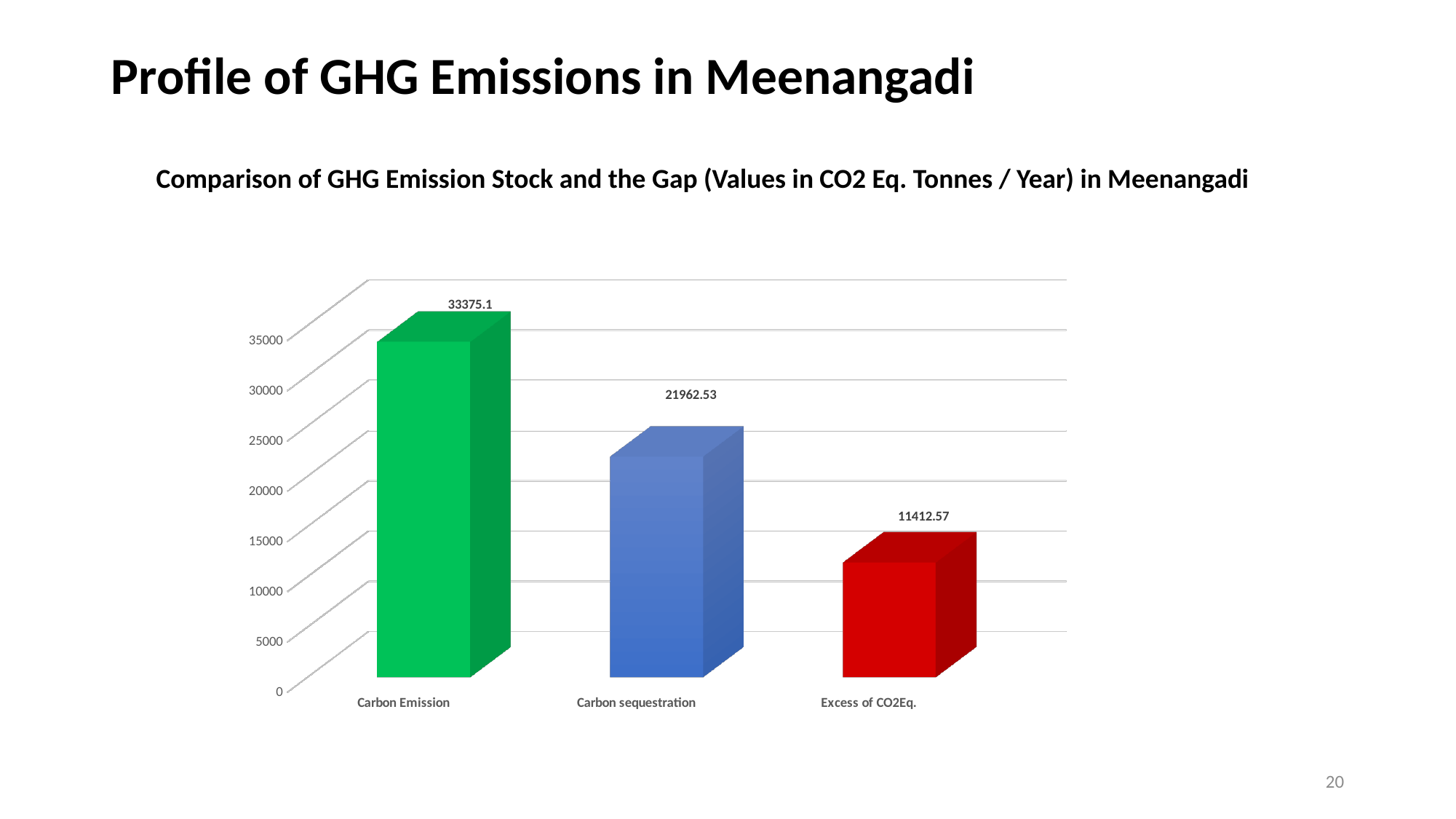
What is the value for Carbon sequestration? 21962.53 What is the value for Carbon Emission? 33375.1 What is the difference between the Carbon Emission value and the Carbon sequestration value? 11412.57 What is the title of the chart? Comparison of GHG Emission Stock and the Gap (Values in CO2 Eq. Tonnes / Year) in Meenangadi What kind of chart is shown on the slide? Bar chart How many categories are shown in the chart? 3 Is the value for Carbon sequestration greater or less than 20000? greater Which category has the lowest value? Excess of CO2Eq. Which category has the highest value? Carbon Emission What is the value for Excess of CO2Eq.? 11412.57 What is the difference between the Carbon sequestration value and the Excess of CO2Eq. value? 10549.96 Which is larger, Carbon sequestration or Excess of CO2Eq.? Carbon sequestration